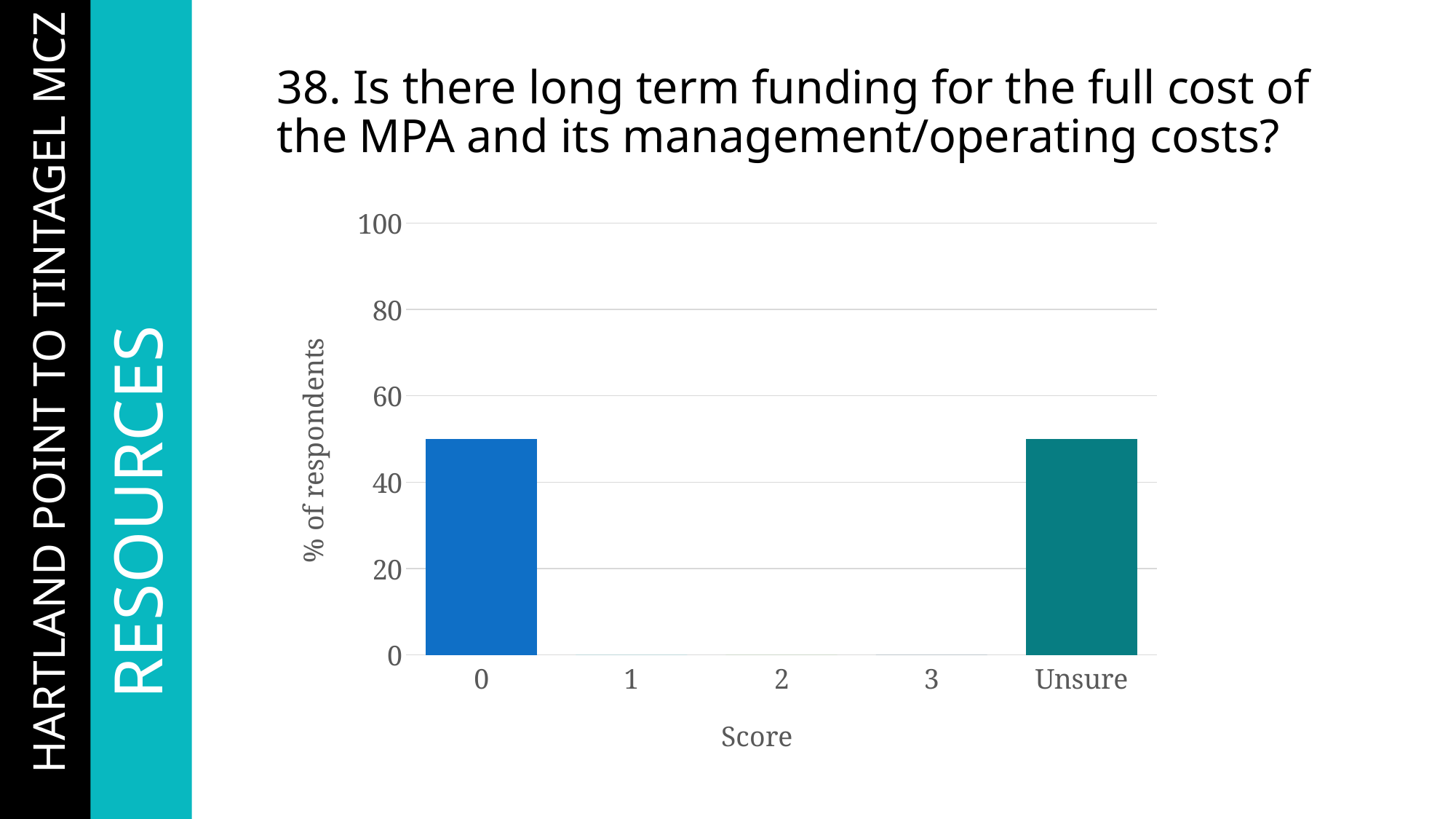
Is the value for score 0 greater or less than 40? greater Is the value for score 0 greater or less than 60? less What kind of chart is shown on the slide? bar chart Is the value for Unsure greater or less than 60? less How many categories are shown on the x axis of the chart? 5 Which is larger, the value for Unsure or the value for score 3? Unsure Which is larger, the value for score 0 or the value for score 1? score 0 What is the label of the x axis of the chart? Score What is the label of the y axis of the chart? % of respondents